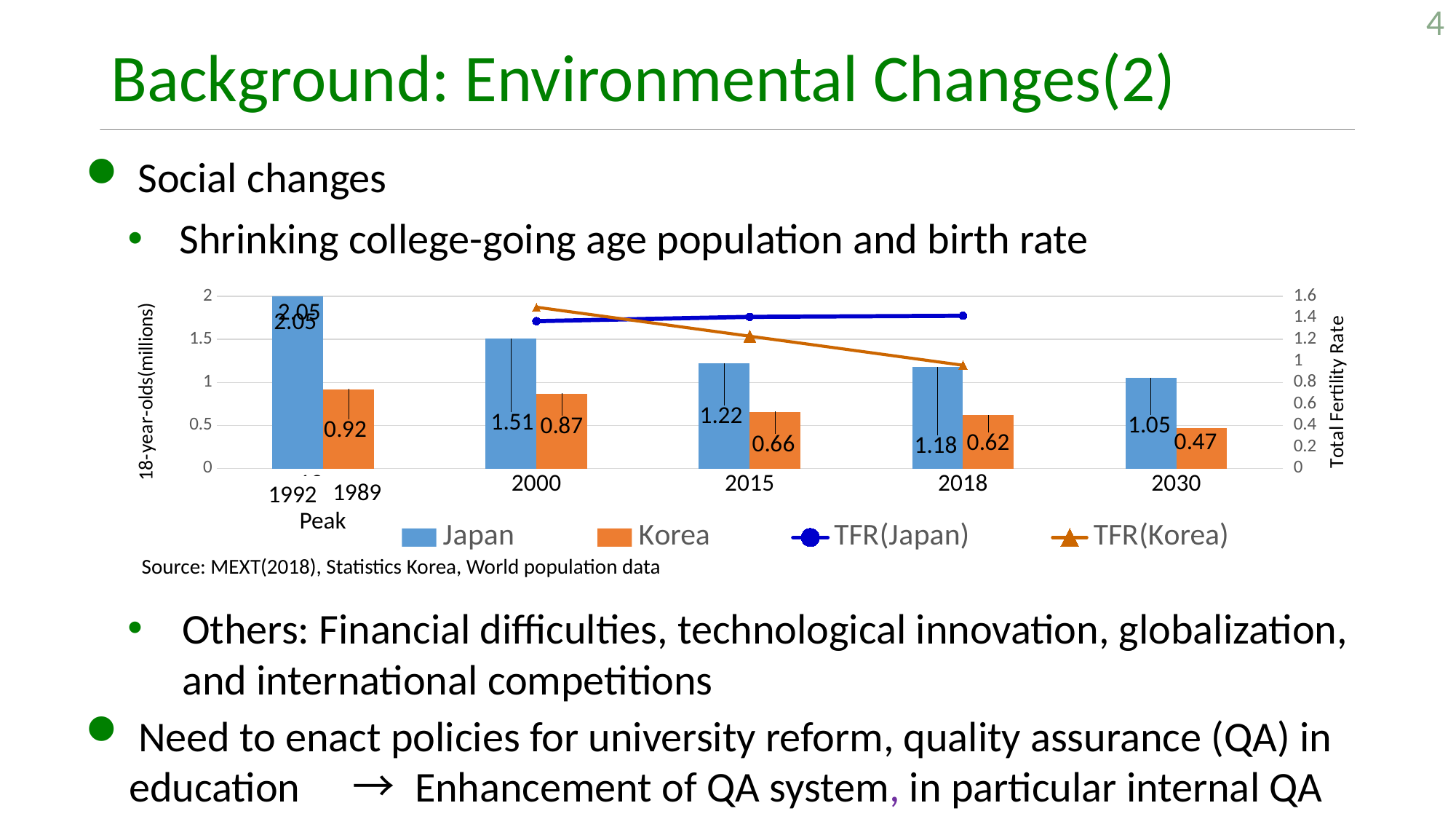
Which category has the highest value for Japan? 1992 Peak What kind of chart is this? Combined bar and line chart What is the value for Korea in 2015? 0.66 Do the Japan bar values rise or fall from the 1992 Peak to 2030? fall How many year categories are shown on the x axis? 5 How many series does the legend list? 4 Which is larger, the Korea value in 2000 or the Korea value in 2018? 2000 What is the value for Korea in 2030? 0.47 Is the TFR(Korea) value in 2018 greater or less than 1.2? less What is the value for Japan in 2000? 1.51 Which category has the lowest value for Korea? 2030 What is the difference between the Japan and Korea values in 2018? 0.56